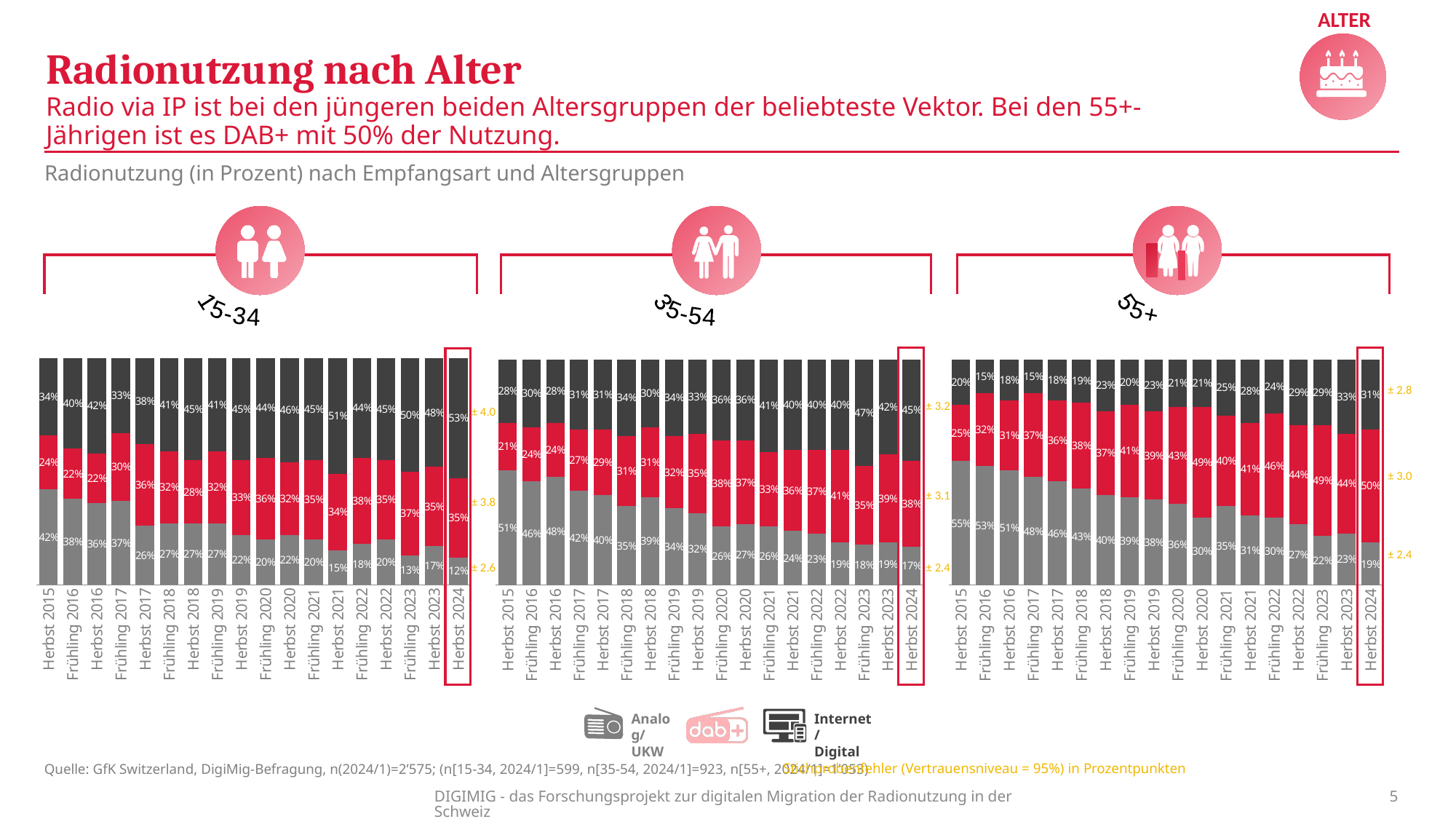
Which survey wave is highlighted with a red box in all three charts? Herbst 2024 How many survey waves (bars) are shown in the 15-34 chart? 18 In the 55+ chart, does the Analog/UKW share rise or fall from Herbst 2015 to Herbst 2024? Fall In the 15-34 chart, by how many percentage points did the Analog/UKW share fall from Herbst 2015 to Herbst 2024? 30 percentage points How many reception types (series) does the legend list? 3 In the 15-34 chart, what is the Internet/Digital share for Herbst 2024? 53% What kind of chart is used for each age group on this slide? Stacked bar chart In the 55+ chart, what is the DAB+ share for Herbst 2024? 50% In the 35-54 chart, what is the DAB+ share for Herbst 2024? 38% In the 35-54 chart, what is the Analog/UKW share for Herbst 2015? 51% In the 55+ chart for Herbst 2024, which is larger: DAB+ or Internet/Digital? DAB+ In the 35-54 chart for Herbst 2024, which reception type has the largest share? Internet/Digital